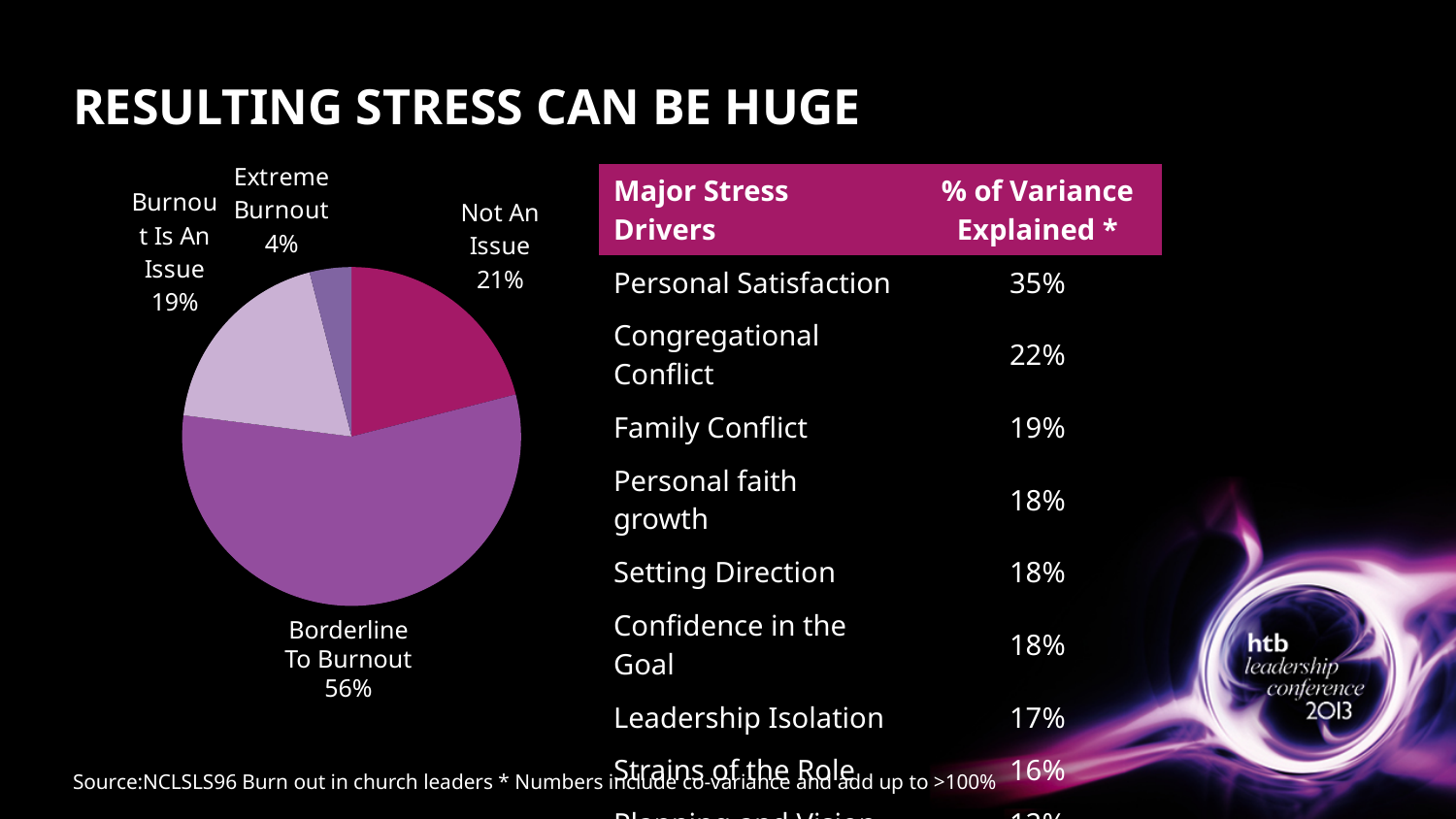
What share of the pie chart is labelled "Not An Issue"? 21% What share of the pie chart is labelled "Borderline To Burnout"? 56% What is the title of the slide containing the pie chart? RESULTING STRESS CAN BE HUGE What share of the pie chart is labelled "Burnout Is An Issue"? 19% How many slices does the pie chart have? 4 Which slice of the pie chart is the smallest? Extreme Burnout What is the difference in percentage points between the "Borderline To Burnout" slice and the "Not An Issue" slice? 35 Which is larger in the pie chart: "Not An Issue" or "Burnout Is An Issue"? Not An Issue Which slice of the pie chart is the largest? Borderline To Burnout What kind of chart is shown on the slide? Pie chart What is the difference in percentage points between the "Burnout Is An Issue" slice and the "Extreme Burnout" slice? 15